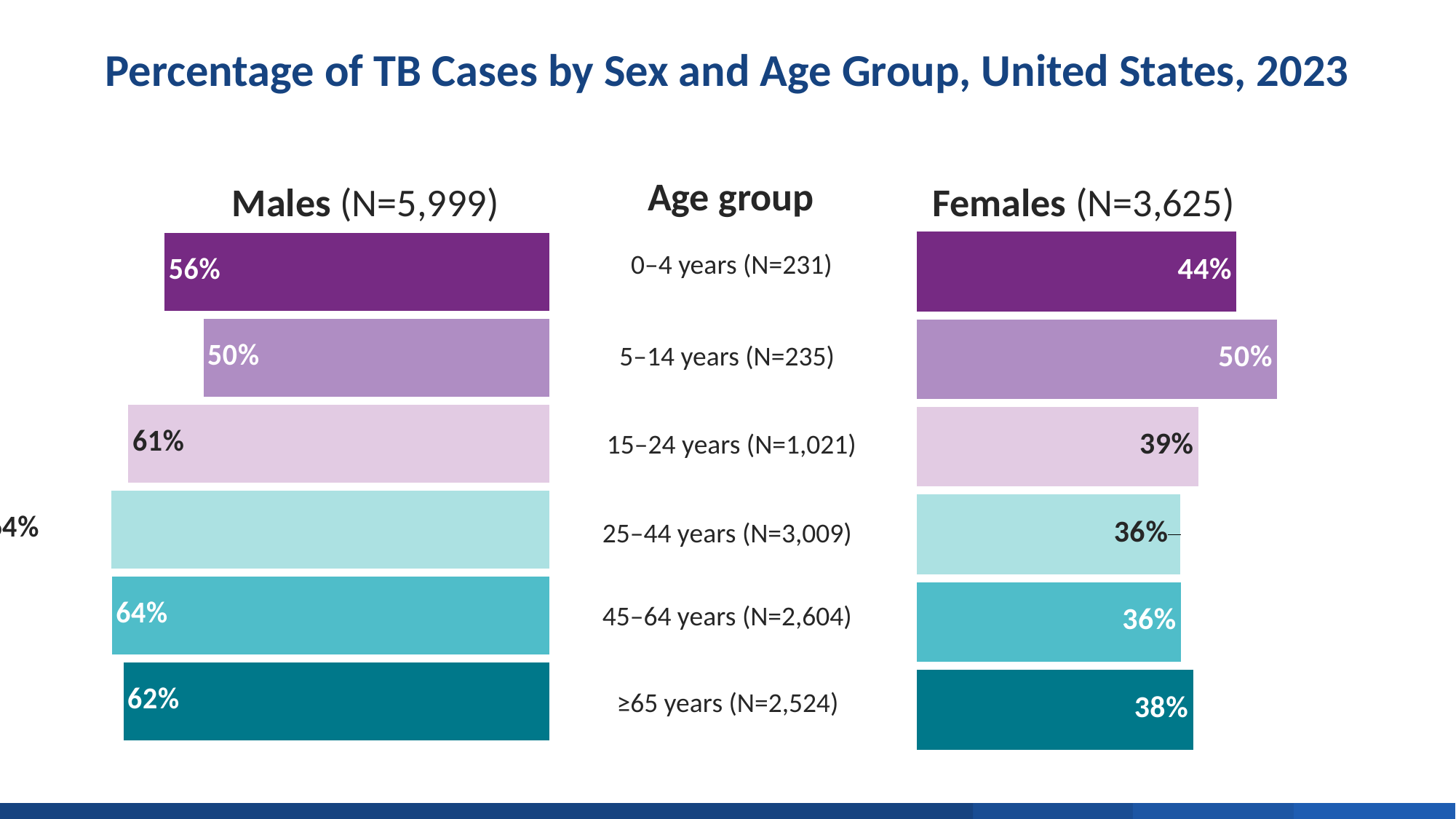
What percentage of TB cases among 15–24 years were female? 39% What is the total number of male TB cases (N) shown in the chart heading? 5,999 Which age group has the lowest female percentage? 25–44 years and 45–64 years (36%) Among the age groups with printed male values, which age group has the highest male percentage? 45–64 years What percentage of TB cases among 0–4 years were male? 56% What is the difference between the male and female percentages for the 15–24 years age group? 22 percentage points What is the N for the 25–44 years age group? 3,009 What percentage of TB cases among ≥65 years were male? 62% Which is larger, the female percentage for 0–4 years or the female percentage for ≥65 years? 0–4 years How many age groups are shown in the chart? 6 What kind of chart is shown on the slide? Bar chart What percentage of TB cases among 45–64 years were female? 36%